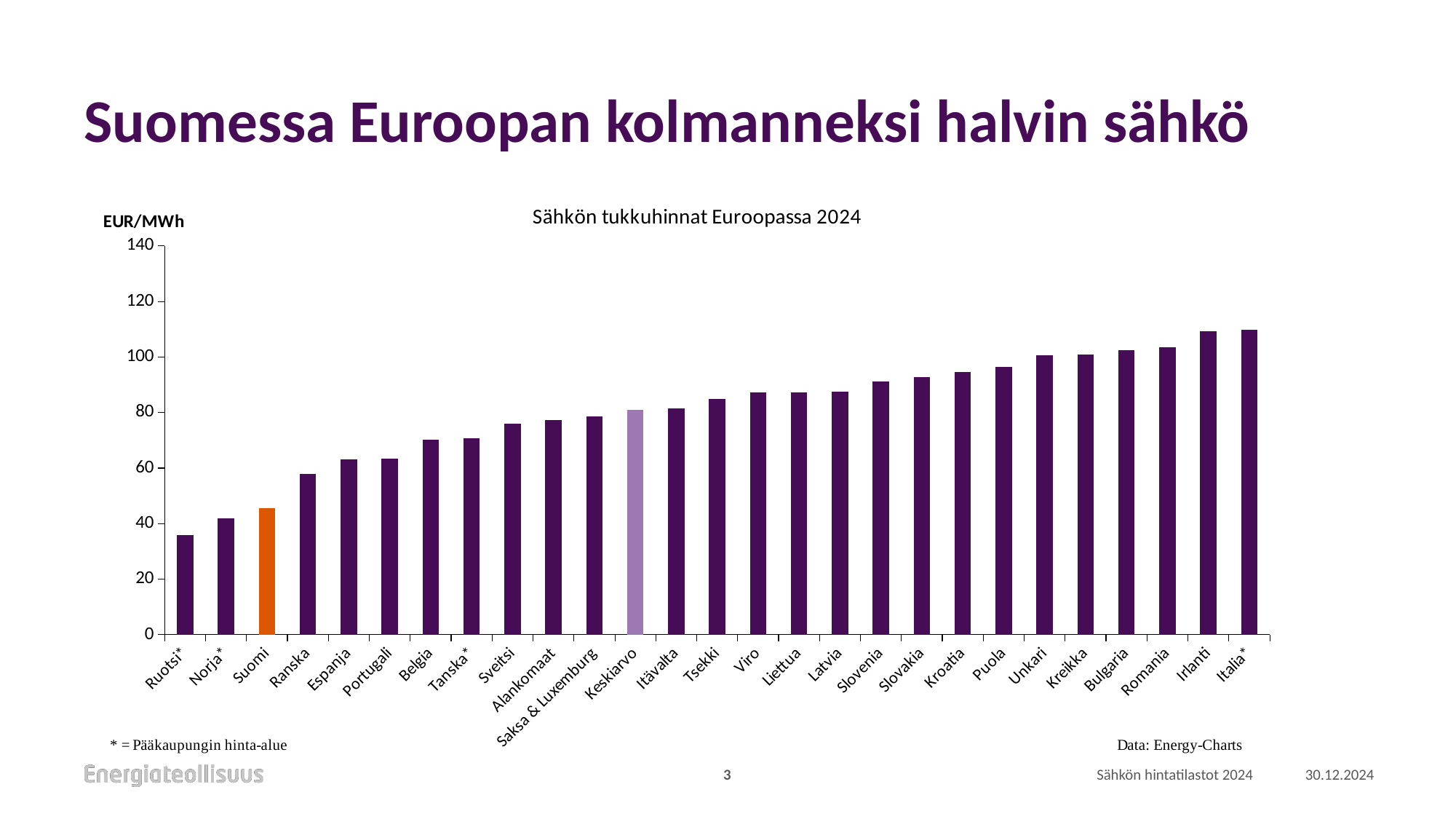
Which category has the lowest value in the chart? Ruotsi* What unit is shown on the y axis of the chart? EUR/MWh Is the value for Suomi greater or less than 60? less What kind of chart is shown on the slide? bar chart Which has a higher value, Suomi or Ranska? Ranska Do the values generally rise or fall from left to right along the x axis? rise Is the value for Puola greater or less than 100? less What is the title of the chart? Sähkön tukkuhinnat Euroopassa 2024 How many bars (categories) are plotted in the chart? 27 Is the value for Italia* greater or less than 100? greater